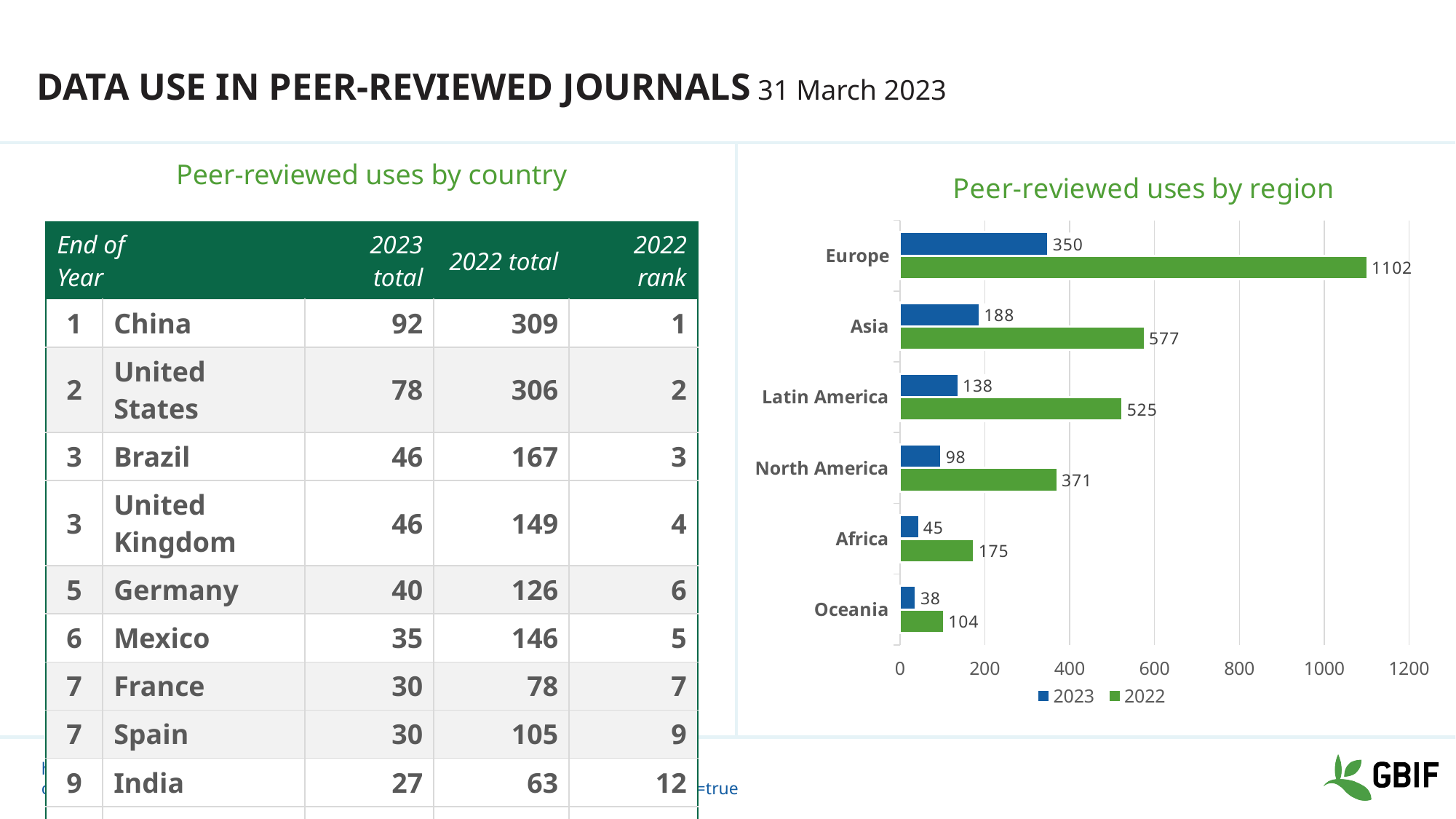
What is the 2023 value for Asia in the 'Peer-reviewed uses by region' chart? 188 Which region has the highest 2022 value in the 'Peer-reviewed uses by region' chart? Europe In the 'Peer-reviewed uses by region' chart, is the 2022 value for Asia greater or less than 400? greater Which region has the lowest 2023 value in the 'Peer-reviewed uses by region' chart? Oceania In the 'Peer-reviewed uses by region' chart, which colour represents the 2022 series? Green What type of chart is 'Peer-reviewed uses by region'? Bar chart In the 'Peer-reviewed uses by region' chart, which is larger: the 2023 value for North America or the 2023 value for Africa? North America In the 'Peer-reviewed uses by region' chart, what is the difference between the 2022 and 2023 values for Latin America? 387 How many regions are shown in the 'Peer-reviewed uses by region' chart? 6 How many series does the legend of the 'Peer-reviewed uses by region' chart list? 2 What is the 2023 value for Oceania in the 'Peer-reviewed uses by region' chart? 38 What is the 2022 value for Europe in the 'Peer-reviewed uses by region' chart? 1102